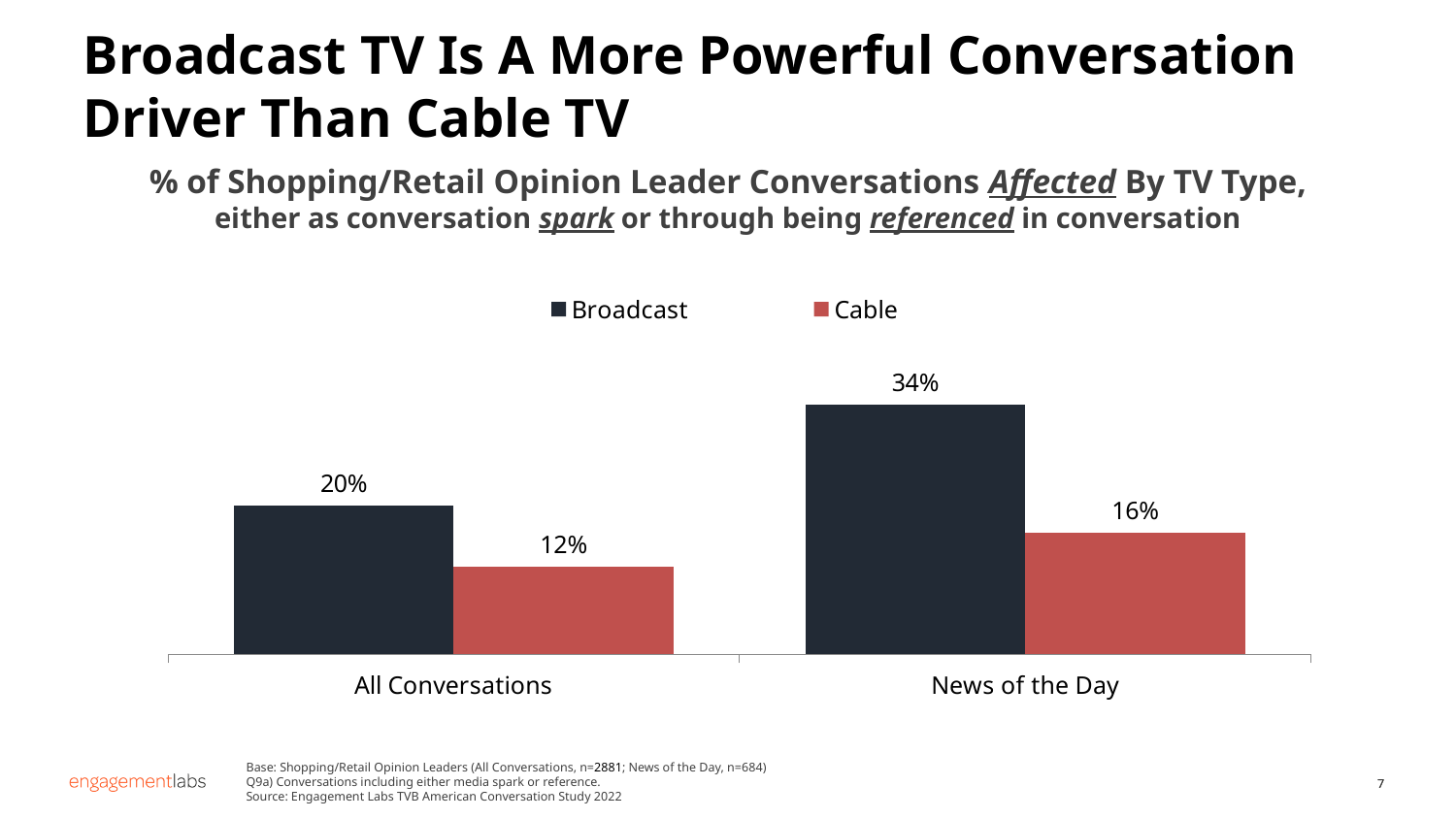
For All Conversations, which is larger, Broadcast or Cable? Broadcast What is the Broadcast value for All Conversations? 20% What is the difference between the Broadcast values for News of the Day and All Conversations? 14% What is the difference between the Broadcast and Cable values for News of the Day? 18% How many series does the legend list? 2 Which category has the highest Broadcast value? News of the Day How many categories are shown on the x axis? 2 What is the Cable value for News of the Day? 16% What is the Cable value for All Conversations? 12% What is the Broadcast value for News of the Day? 34% Which category has the lowest Cable value? All Conversations What kind of chart is shown on the slide? Bar chart